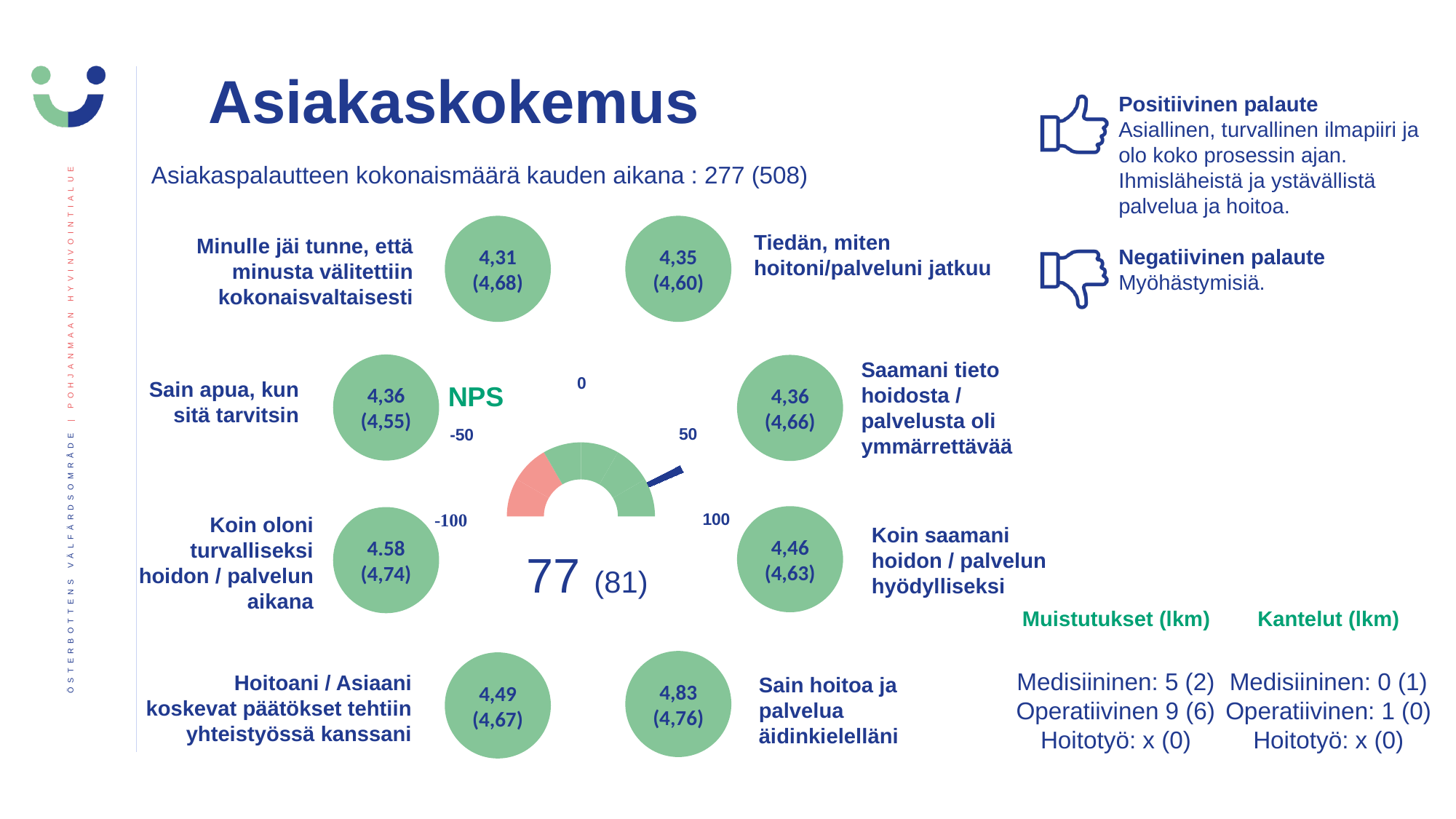
Which of the two NPS values is larger, the current value or the value in parentheses? the value in parentheses (81) What is the difference between the current NPS value (77) and the value in parentheses (81)? 4 What is the value shown in parentheses below the NPS gauge? 81 Is the NPS value on the gauge greater or less than 50? greater Which statement has the highest score among the green circles? Sain hoitoa ja palvelua äidinkielelläni What is the current NPS value shown on the gauge chart? 77 What is the score shown in the circle for 'Sain hoitoa ja palvelua äidinkielelläni'? 4,83 (4,76) Which statement has the lowest score among the green circles? Minulle jäi tunne, että minusta välitettiin kokonaisvaltaisesti How many tick labels are shown on the NPS gauge scale? 5 What is the highest value labelled on the NPS gauge scale? 100 What kind of chart is used to display the NPS? gauge chart What is the lowest value labelled on the NPS gauge scale? -100